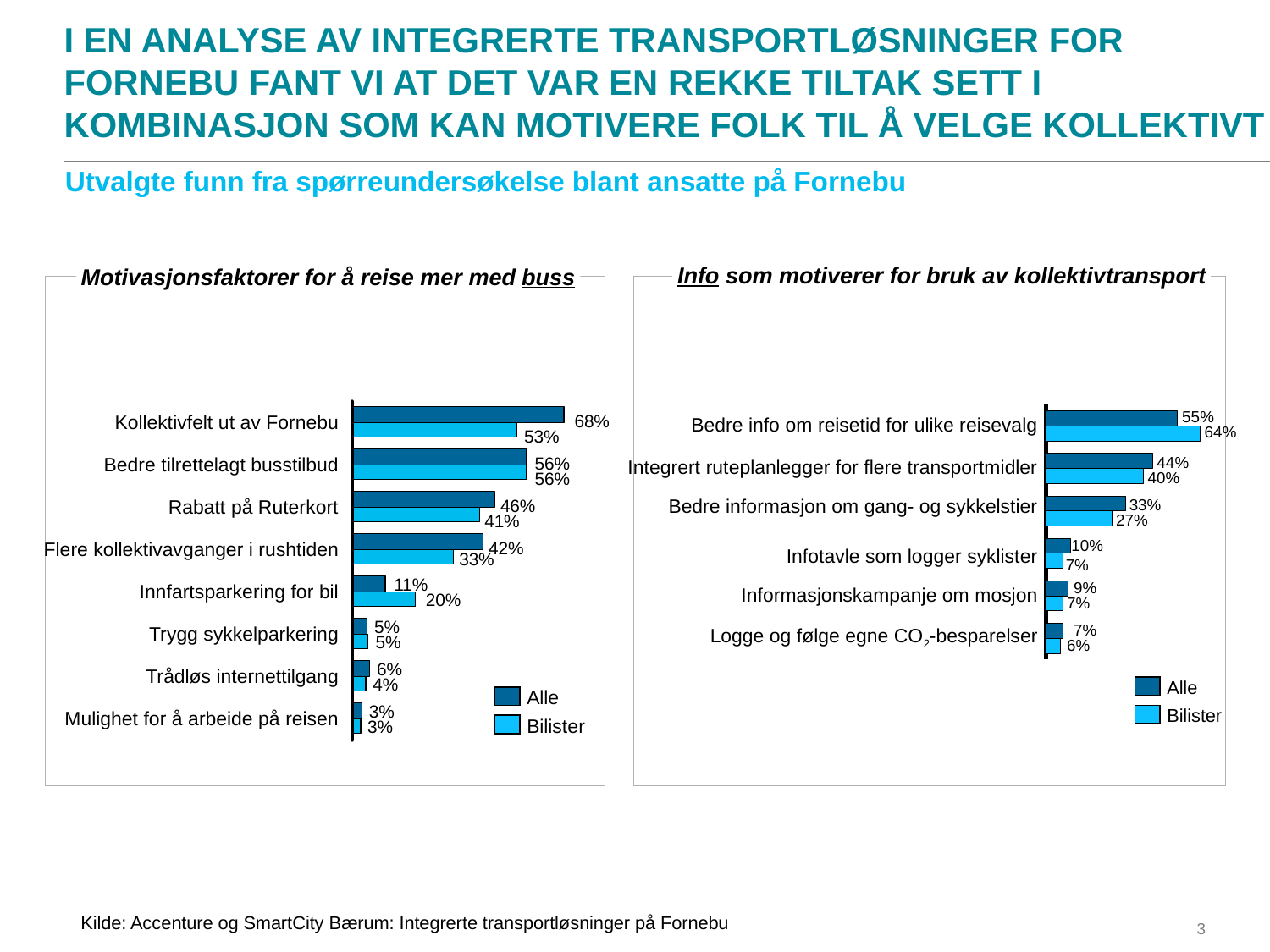
In the chart 'Motivasjonsfaktorer for å reise mer med buss', which category has the highest value for 'Alle'? Kollektivfelt ut av Fornebu In the chart 'Motivasjonsfaktorer for å reise mer med buss', which category has the lowest value for 'Bilister'? Mulighet for å arbeide på reisen In the chart 'Info som motiverer for bruk av kollektivtransport', what is the difference between the 'Bilister' and 'Alle' values for 'Bedre info om reisetid for ulike reisevalg'? 9% In the chart 'Info som motiverer for bruk av kollektivtransport', what is the value for 'Bilister' for 'Bedre info om reisetid for ulike reisevalg'? 64% In the chart 'Info som motiverer for bruk av kollektivtransport', how many series does the legend list? 2 In the chart 'Motivasjonsfaktorer for å reise mer med buss', what is the difference between the 'Alle' and 'Bilister' values for 'Kollektivfelt ut av Fornebu'? 15% In the chart 'Info som motiverer for bruk av kollektivtransport', what is the value for 'Alle' for 'Bedre informasjon om gang- og sykkelstier'? 33% In the chart 'Motivasjonsfaktorer for å reise mer med buss', how many categories are shown? 8 In the chart 'Motivasjonsfaktorer for å reise mer med buss', what is the value for 'Bilister' for 'Innfartsparkering for bil'? 20% What kind of chart is 'Info som motiverer for bruk av kollektivtransport'? Bar chart In the chart 'Info som motiverer for bruk av kollektivtransport', which is larger for 'Integrert ruteplanlegger for flere transportmidler': the 'Alle' value or the 'Bilister' value? Alle In the chart 'Motivasjonsfaktorer for å reise mer med buss', what is the value for 'Alle' for 'Kollektivfelt ut av Fornebu'? 68%